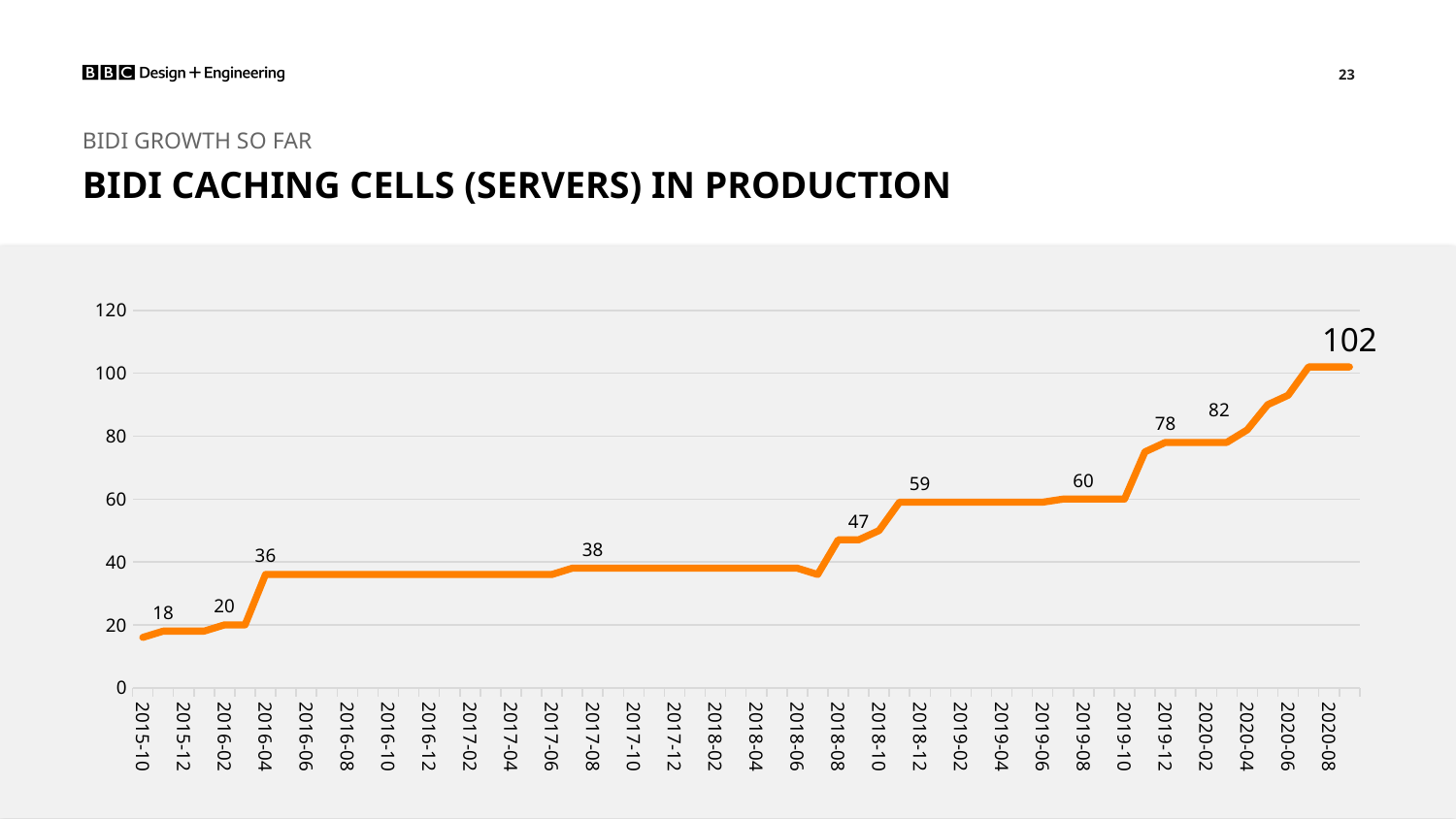
What is the highest value labeled on the line? 102 What kind of chart is shown on the slide? line chart Do the values generally rise or fall from 2015-10 to 2020-08? rise What is the first data label shown on the line, near the start of the series? 18 How many data labels are printed on the line? 10 Is the value at 2019-04 greater or less than 40? greater What is the lowest value labeled on the line? 18 Is the value at 2017-02 greater or less than 40? less What is the difference between the labeled values 82 and 78? 4 What is the last data label shown on the line, at 2020-08? 102 Which labeled value is larger, 59 or 47? 59 What is the difference between the highest labeled value (102) and the lowest labeled value (18)? 84